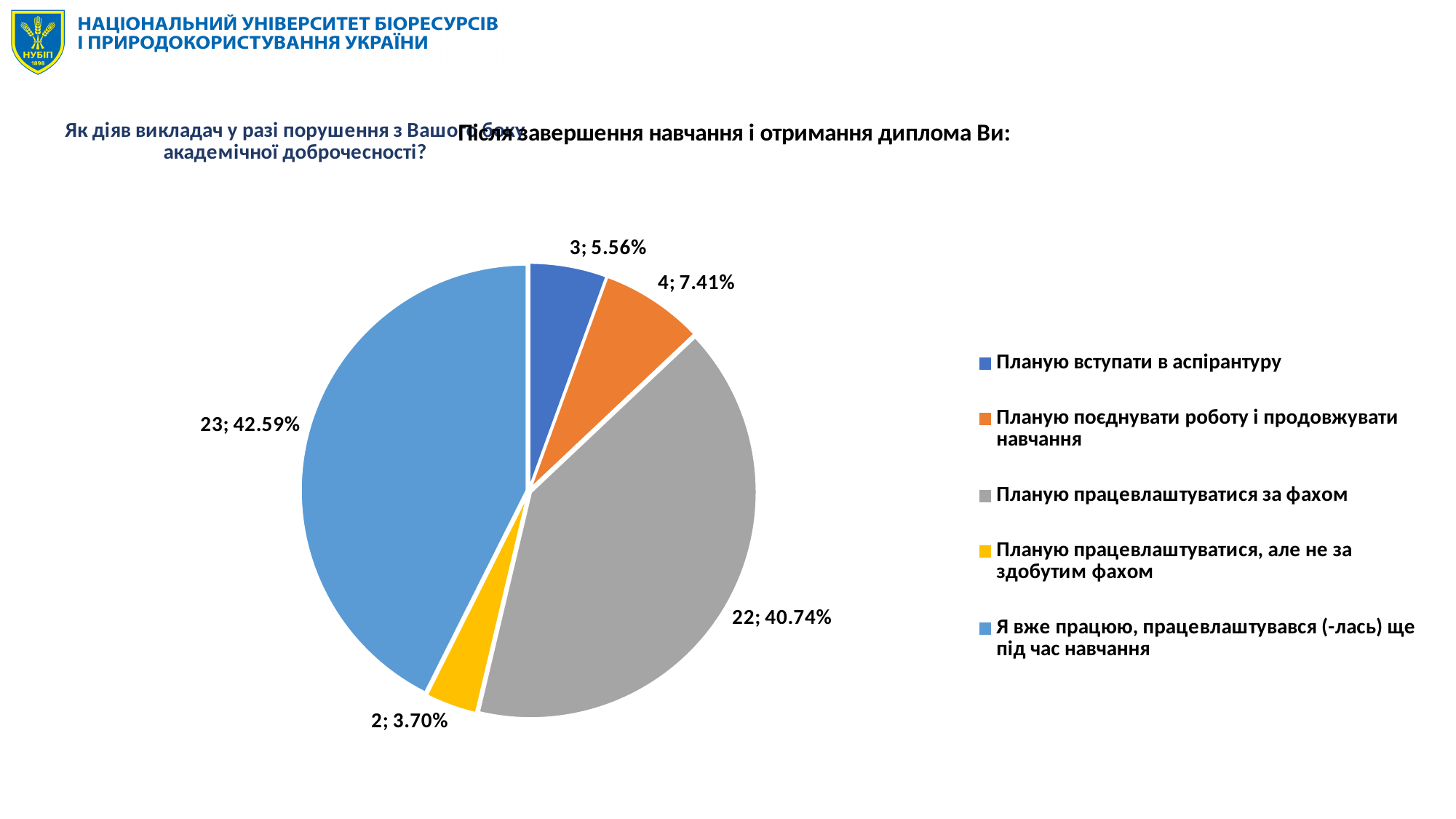
Which has more respondents: "Планую вступати в аспірантуру" or "Планую поєднувати роботу і продовжувати навчання"? Планую поєднувати роботу і продовжувати навчання What kind of chart is shown on the slide? pie chart What is the total number of respondents across all slices of the pie? 54 What is the difference in count between "Я вже працюю, працевлаштувався (-лась) ще під час навчання" and "Планую працевлаштуватися за фахом"? 1 What percentage share is shown for "Планую поєднувати роботу і продовжувати навчання"? 7.41% How many respondents chose "Планую вступати в аспірантуру"? 3 How many respondents chose "Планую працевлаштуватися, але не за здобутим фахом"? 2 Which category has the largest slice of the pie? Я вже працюю, працевлаштувався (-лась) ще під час навчання What colour is the slice for "Планую працевлаштуватися за фахом"? gray How many slices does the pie chart have? 5 What percentage share is shown for "Планую працевлаштуватися за фахом"? 40.74% Which category has the smallest slice of the pie? Планую працевлаштуватися, але не за здобутим фахом